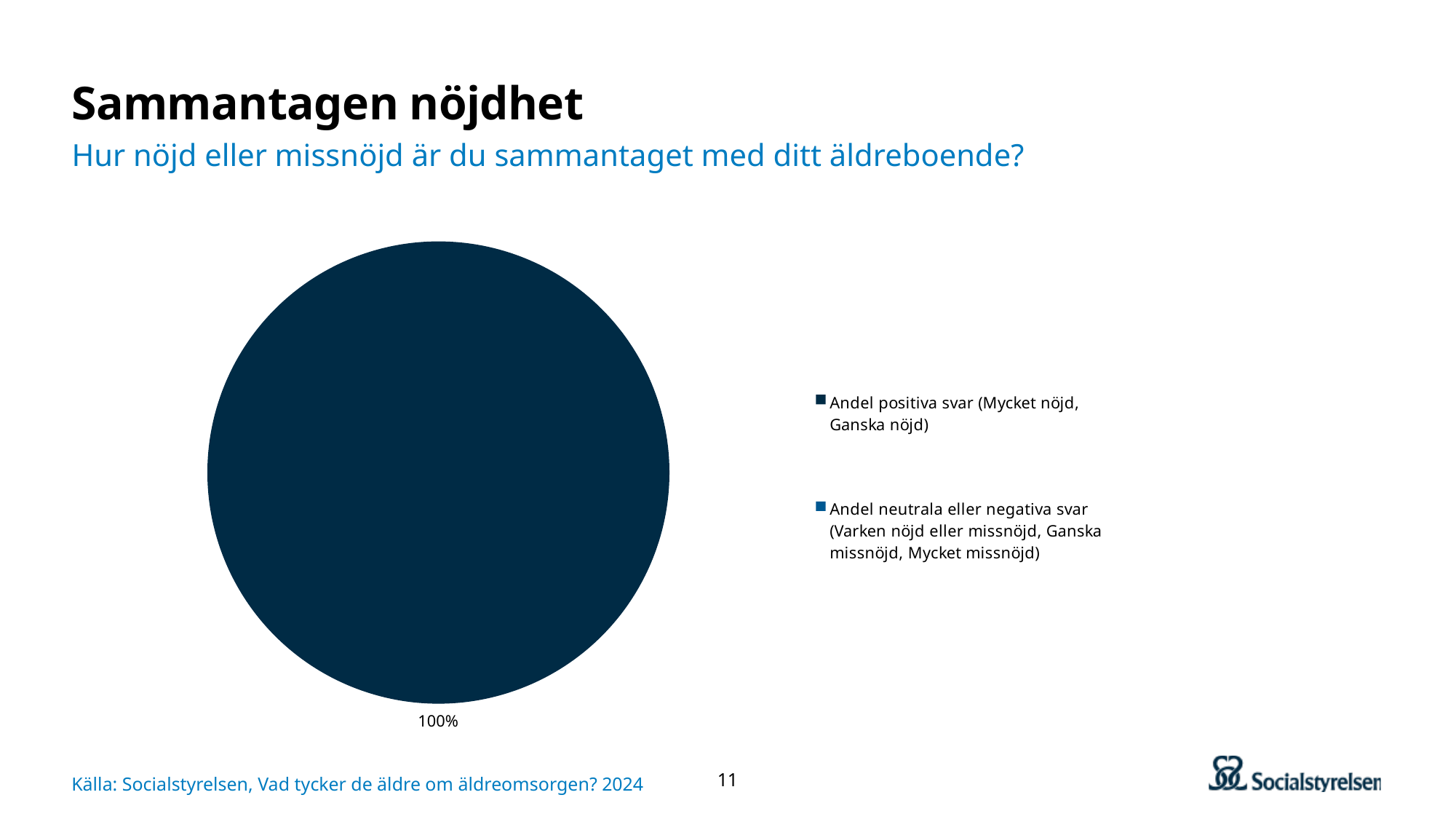
What percentage value is printed as a data label on the pie chart? 100% How many entries does the legend of the pie chart list? 2 Which legend category does the single visible slice of the pie chart belong to? Andel positiva svar (Mycket nöjd, Ganska nöjd) What share of the pie does the slice for 'Andel positiva svar (Mycket nöjd, Ganska nöjd)' take up? 100% What kind of chart is shown on the slide? pie chart What is the title of the slide containing the pie chart? Sammantagen nöjdhet What survey question is shown as the subtitle above the pie chart? Hur nöjd eller missnöjd är du sammantaget med ditt äldreboende? How many slices are visible in the pie chart? 1